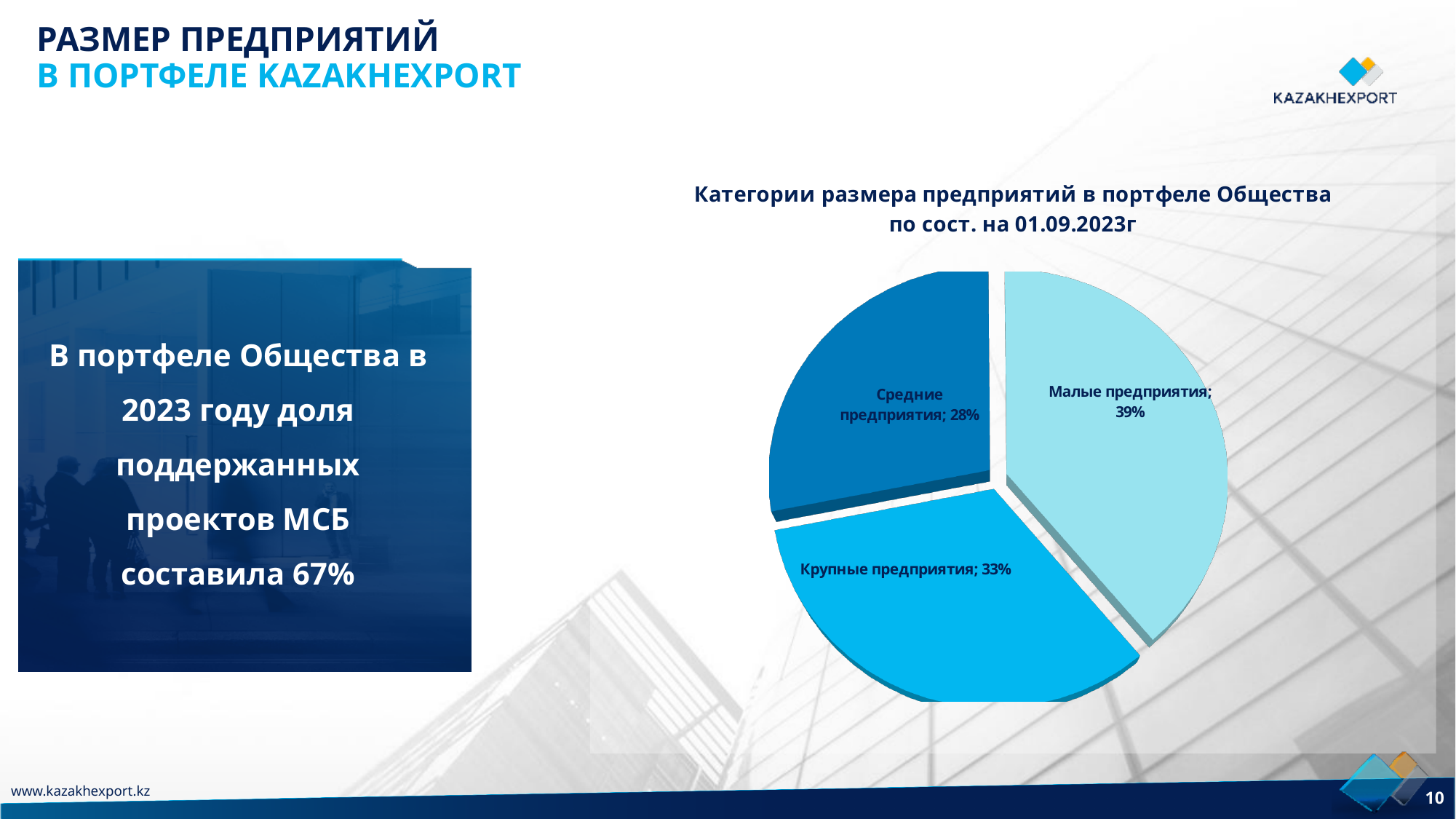
What is the title of the chart on the slide? Категории размера предприятий в портфеле Общества по сост. на 01.09.2023г Which category has the smallest slice in the pie chart? Средние предприятия How many categories are shown in the pie chart? 3 What is the combined share of Малые предприятия and Средние предприятия in the pie chart? 67% What kind of chart is shown on the slide? Pie chart What share of the pie chart is labelled for Средние предприятия? 28% Which category has the largest slice in the pie chart? Малые предприятия Which slice is larger: Крупные предприятия or Средние предприятия? Крупные предприятия What share of the pie chart is labelled for Крупные предприятия? 33% What is the difference in percentage points between the Малые предприятия slice and the Средние предприятия slice? 11 What share of the pie chart is labelled for Малые предприятия? 39% What is the difference in percentage points between the Крупные предприятия slice and the Средние предприятия slice? 5